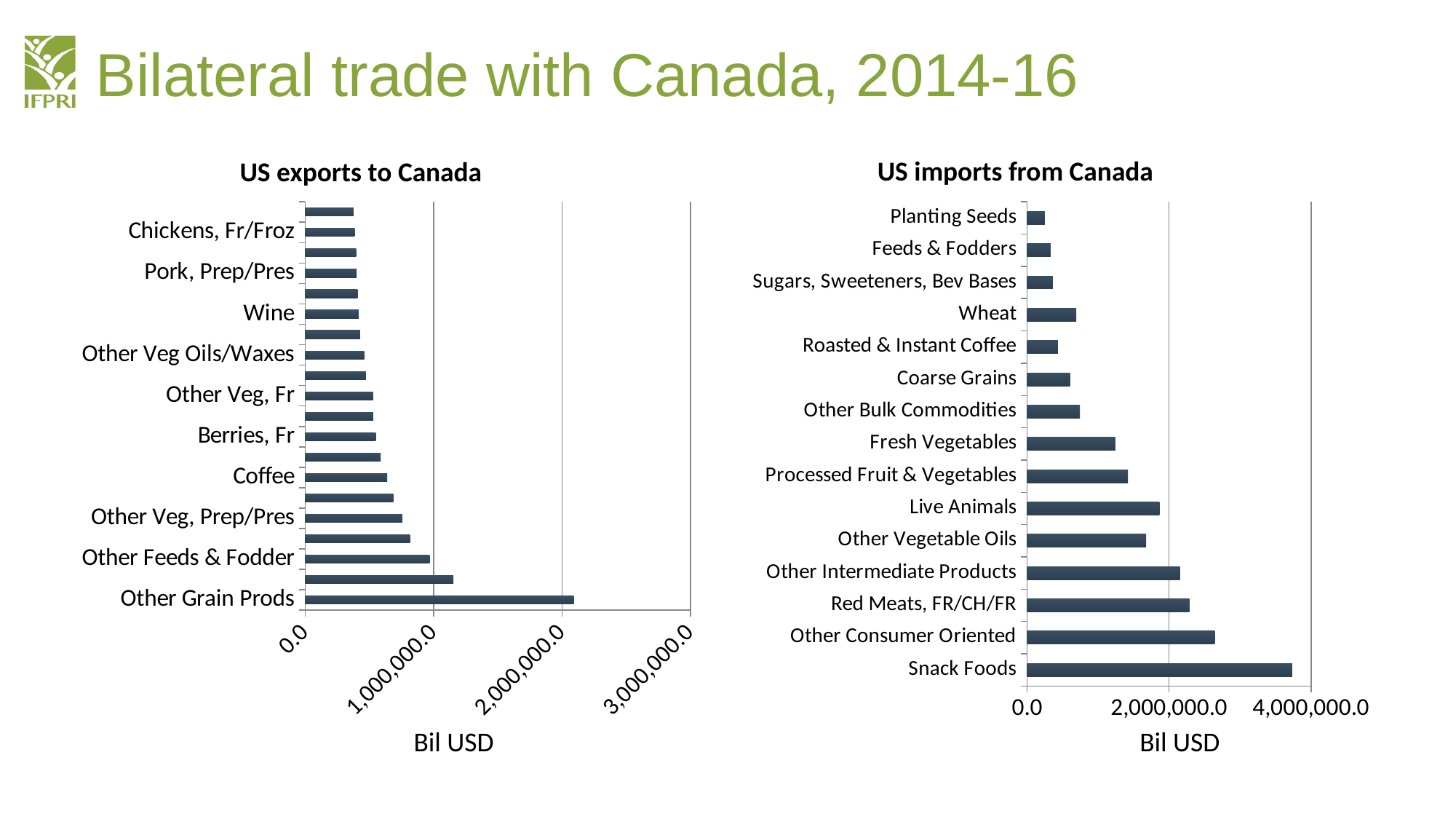
In the 'US imports from Canada' chart, which is larger: Fresh Vegetables or Other Consumer Oriented? Other Consumer Oriented In the 'US imports from Canada' chart, which is larger: Snack Foods or Wheat? Snack Foods In the 'US imports from Canada' chart, which category has the lowest value? Planting Seeds In the 'US imports from Canada' chart, is the value for Snack Foods greater or less than 2,000,000.0? greater How many categories are shown in the 'US imports from Canada' chart? 15 In the 'US exports to Canada' chart, which labeled category has the longest bar? Other Grain Prods In the 'US imports from Canada' chart, which category has the highest value? Snack Foods In the 'US exports to Canada' chart, is the value for Other Grain Prods greater or less than 1,000,000.0? greater In the 'US imports from Canada' chart, is the value for Wheat greater or less than 2,000,000.0? less What is the x-axis title of the 'US imports from Canada' chart? Bil USD In the 'US exports to Canada' chart, which is larger: Other Grain Prods or Wine? Other Grain Prods What kind of chart is the 'US exports to Canada' chart? bar chart